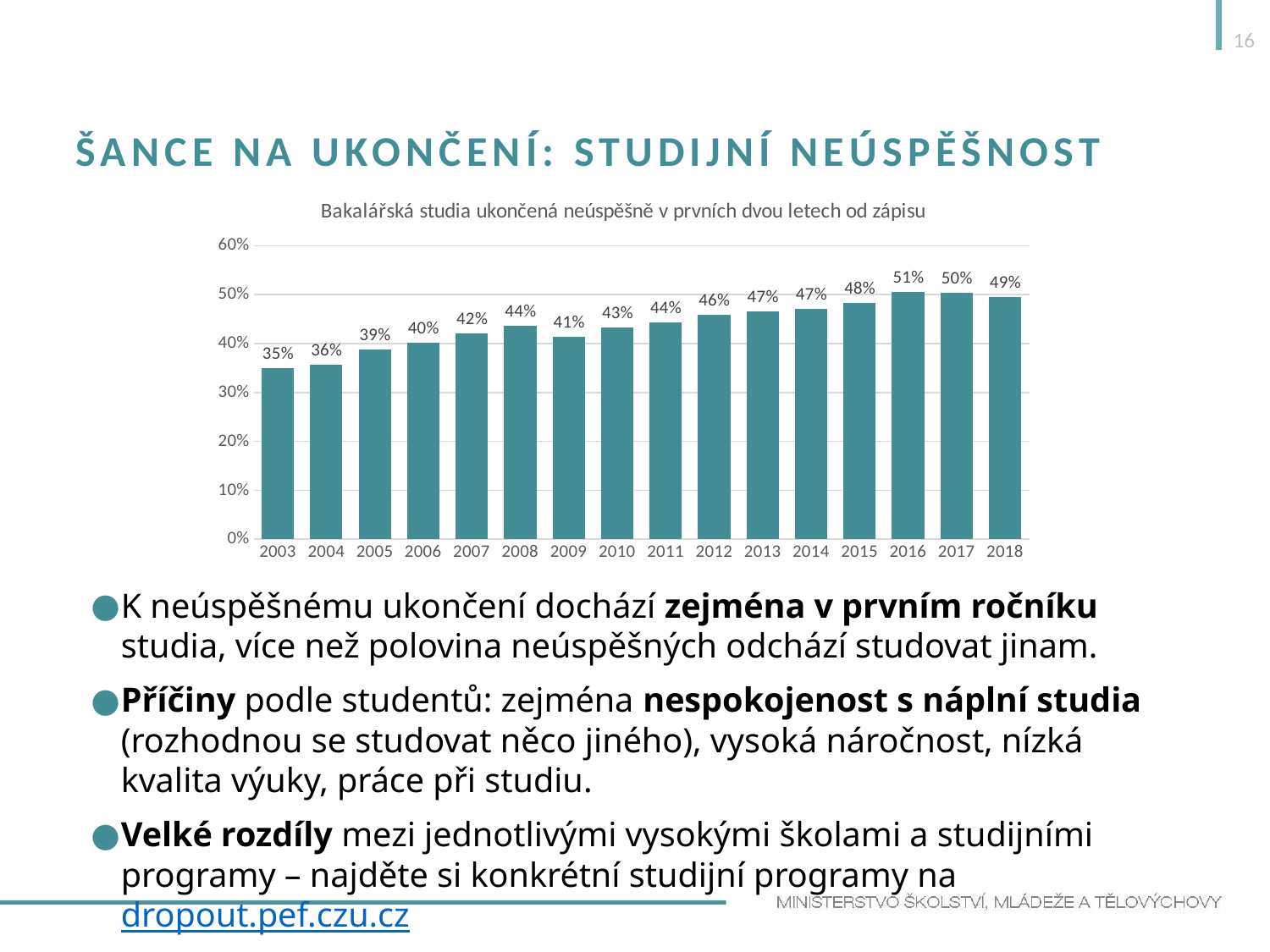
Which year has the lowest value? 2003 What is the value for 2009? 41% What is the title of the chart? Bakalářská studia ukončená neúspěšně v prvních dvou letech od zápisu Which year has the highest value? 2016 How many years are shown on the x axis? 16 What is the difference between the values for 2018 and 2003? 14% Is the value for 2012 greater or less than 40%? greater What kind of chart is shown on the slide? bar chart What is the value for 2016? 51% What is the value for 2003? 35% Which is larger, the value for 2008 or the value for 2009? 2008 Do the values generally rise or fall from 2003 to 2018? rise